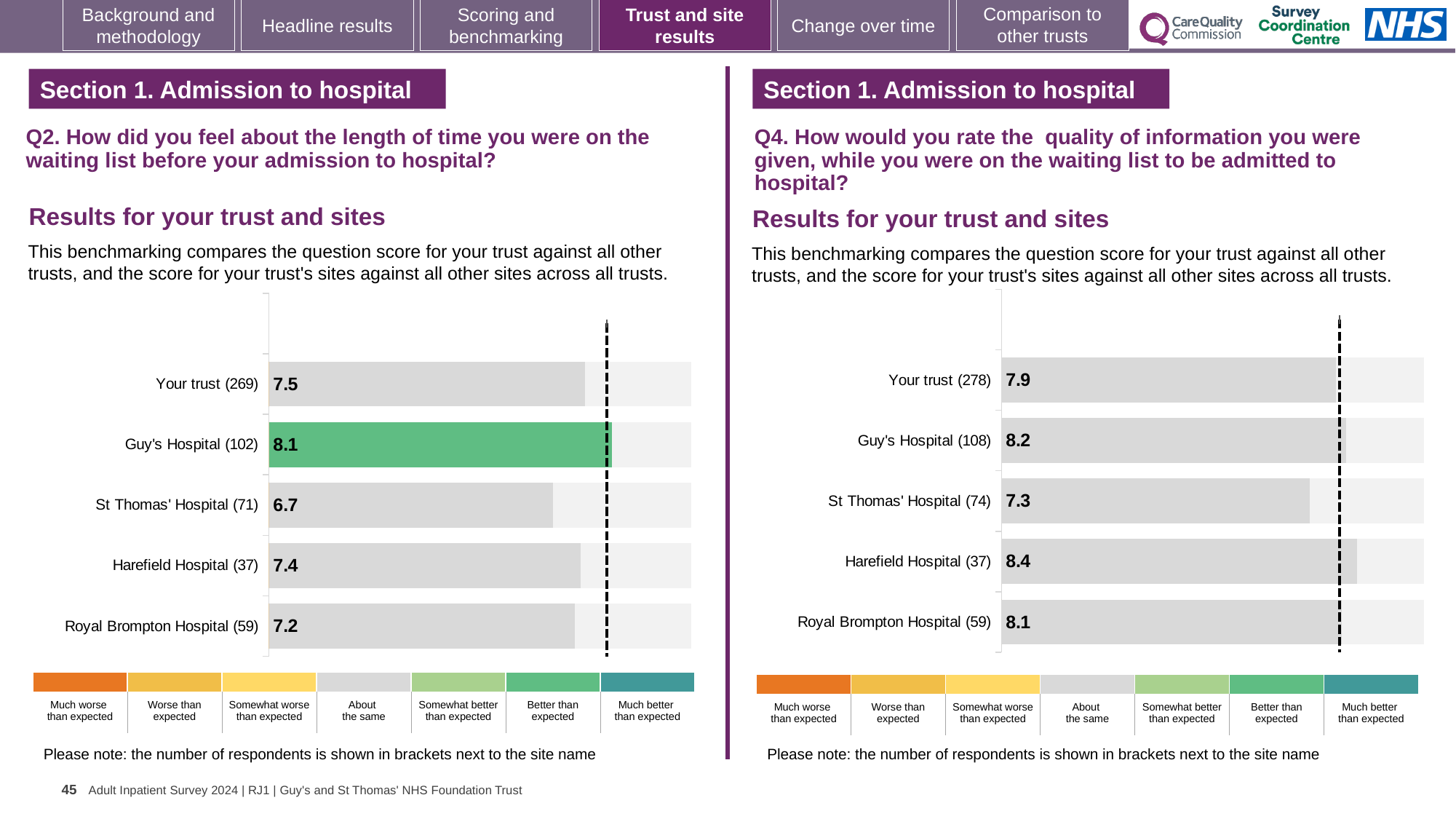
In the Q2 chart on the left, what is the difference between the scores for Guy's Hospital and St Thomas' Hospital? 1.4 In the Q4 chart on the right, what is the score for Harefield Hospital? 8.4 What kind of chart is used for the Q2 results on the left? Bar chart In the Q2 chart on the left, what is the score for Guy's Hospital? 8.1 In the Q4 chart on the right, which site has the highest score? Harefield Hospital In the Q2 chart on the left, which site has the highest score? Guy's Hospital In the Q2 chart on the left, which site's bar is coloured green? Guy's Hospital In the Q4 chart on the right, which has the larger score, Guy's Hospital or St Thomas' Hospital? Guy's Hospital In the Q2 chart on the left, which site has the lowest score? St Thomas' Hospital How many sites (including Your trust) are plotted in the Q4 chart on the right? 5 In the Q4 chart on the right, what is the score for Royal Brompton Hospital? 8.1 In the Q2 chart on the left, what is the score for Your trust? 7.5